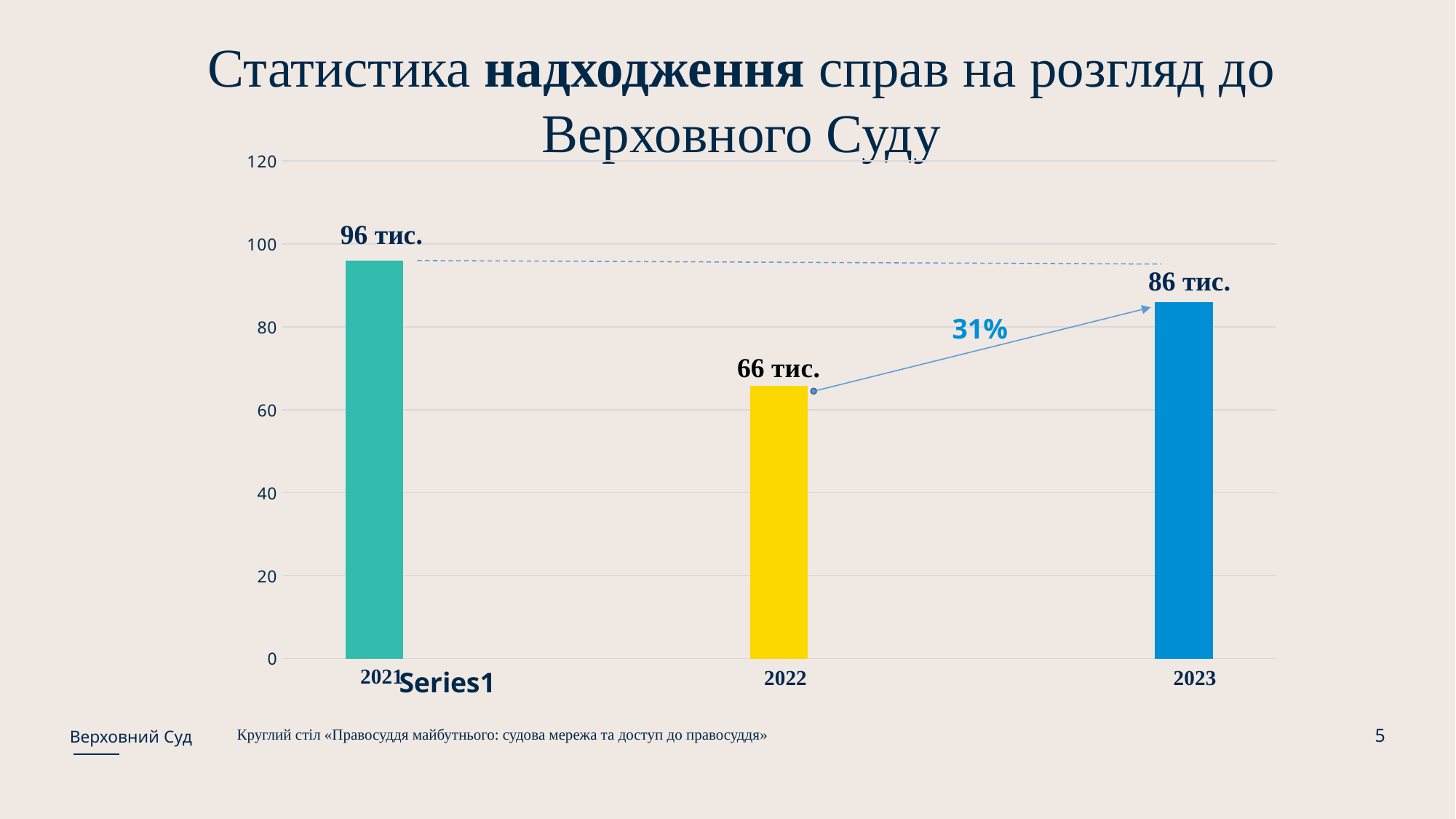
What percentage change is annotated between 2022 and 2023? 31% What is the value shown for 2021? 96 тис. Which year has the highest value? 2021 Is the value for 2022 greater or less than 80? less What kind of chart is shown on the slide? Bar chart What is the difference between the values for 2021 and 2022? 30 тис. What is the value shown for 2022? 66 тис. Which year has the lowest value? 2022 Which is larger, the value for 2021 or the value for 2023? 2021 What is the value shown for 2023? 86 тис. How many years are shown on the chart? 3 What is the difference between the values for 2023 and 2022? 20 тис.